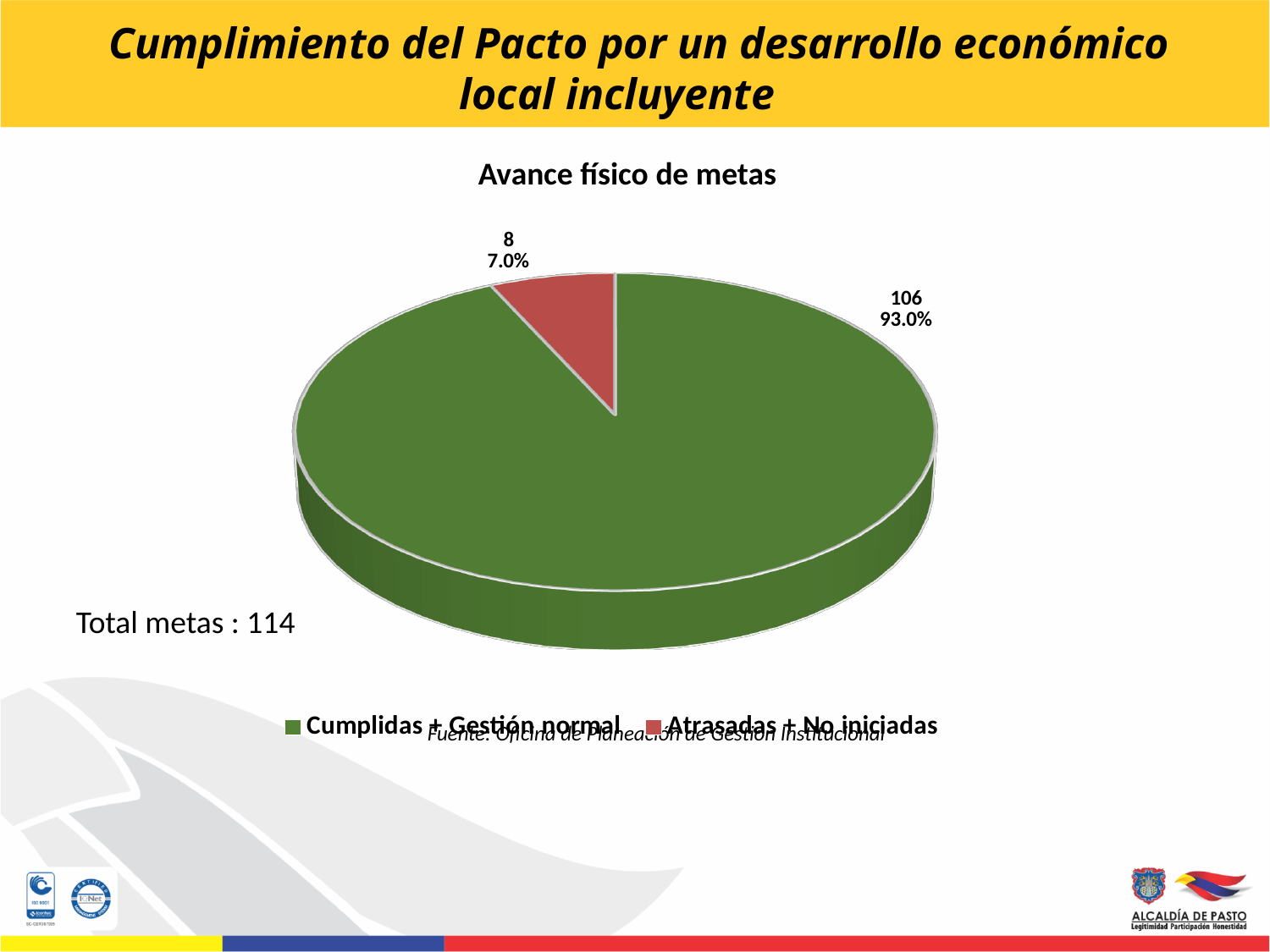
What colour is the slice for Atrasadas + No iniciadas? Red How many entries does the legend list? 2 What is the title of the chart? Avance físico de metas What is the value for Atrasadas + No iniciadas? 8 What type of chart is shown on the slide? Pie chart What share of the pie does Cumplidas + Gestión normal represent? 93.0% Which category has the smallest slice? Atrasadas + No iniciadas What is the value for Cumplidas + Gestión normal? 106 Which category has the largest slice? Cumplidas + Gestión normal What share of the pie does Atrasadas + No iniciadas represent? 7.0% How many slices does the pie chart have? 2 What is the difference between the values for Cumplidas + Gestión normal and Atrasadas + No iniciadas? 98